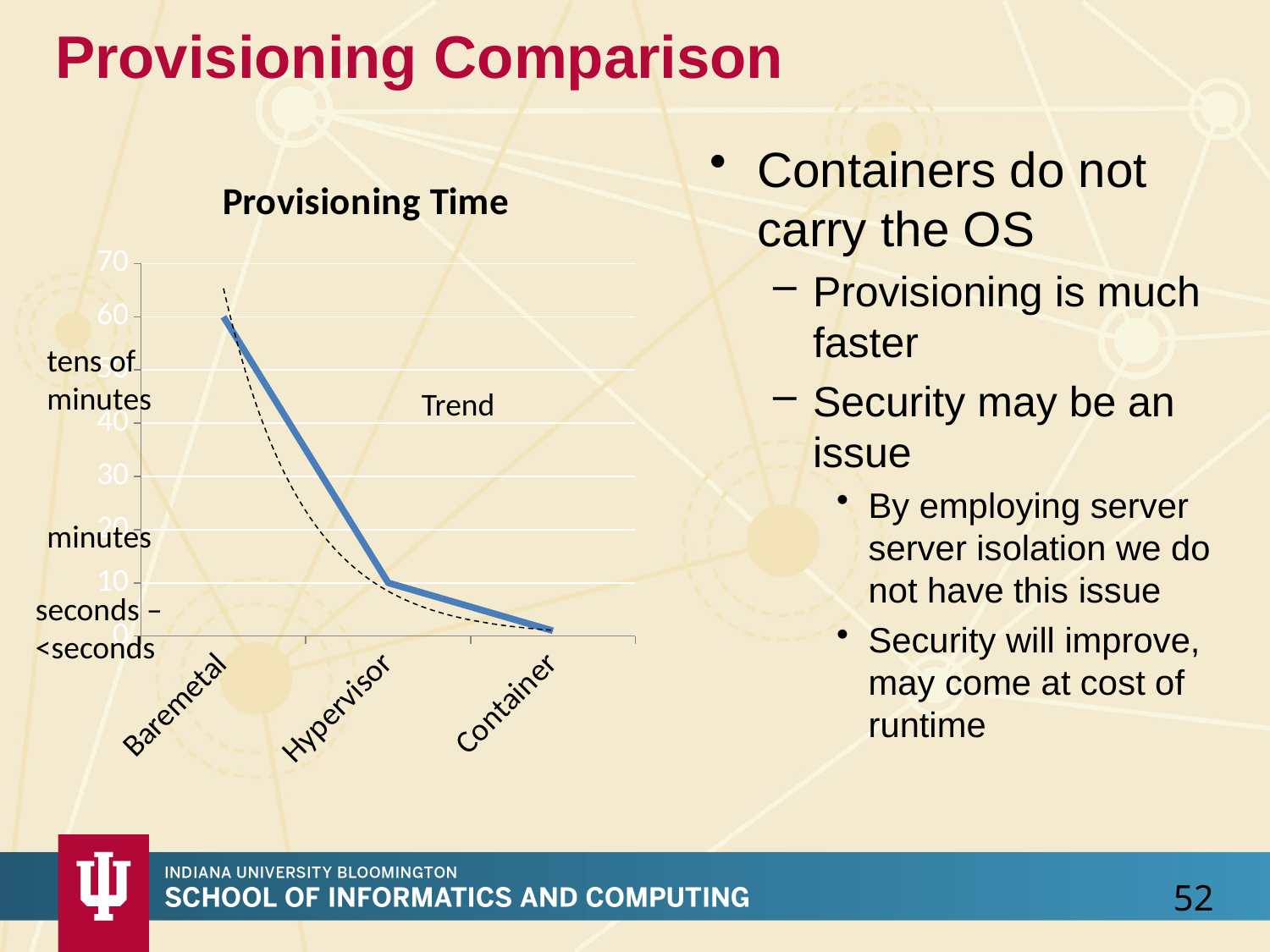
What kind of chart is shown on the slide? line chart What label is given to the dashed line in the chart? Trend What is the title of the chart? Provisioning Time Which has a larger provisioning time, Baremetal or Hypervisor? Baremetal Which category has the lowest provisioning time in the chart? Container Is the value for Baremetal greater or less than 50? greater Which category has the highest provisioning time in the chart? Baremetal How many categories are plotted on the x axis of the chart? 3 Do the values rise or fall from Baremetal to Container along the x axis? fall Which has a larger provisioning time, Hypervisor or Container? Hypervisor Is the value for Hypervisor greater or less than 20? less Is the value for Container greater or less than 10? less